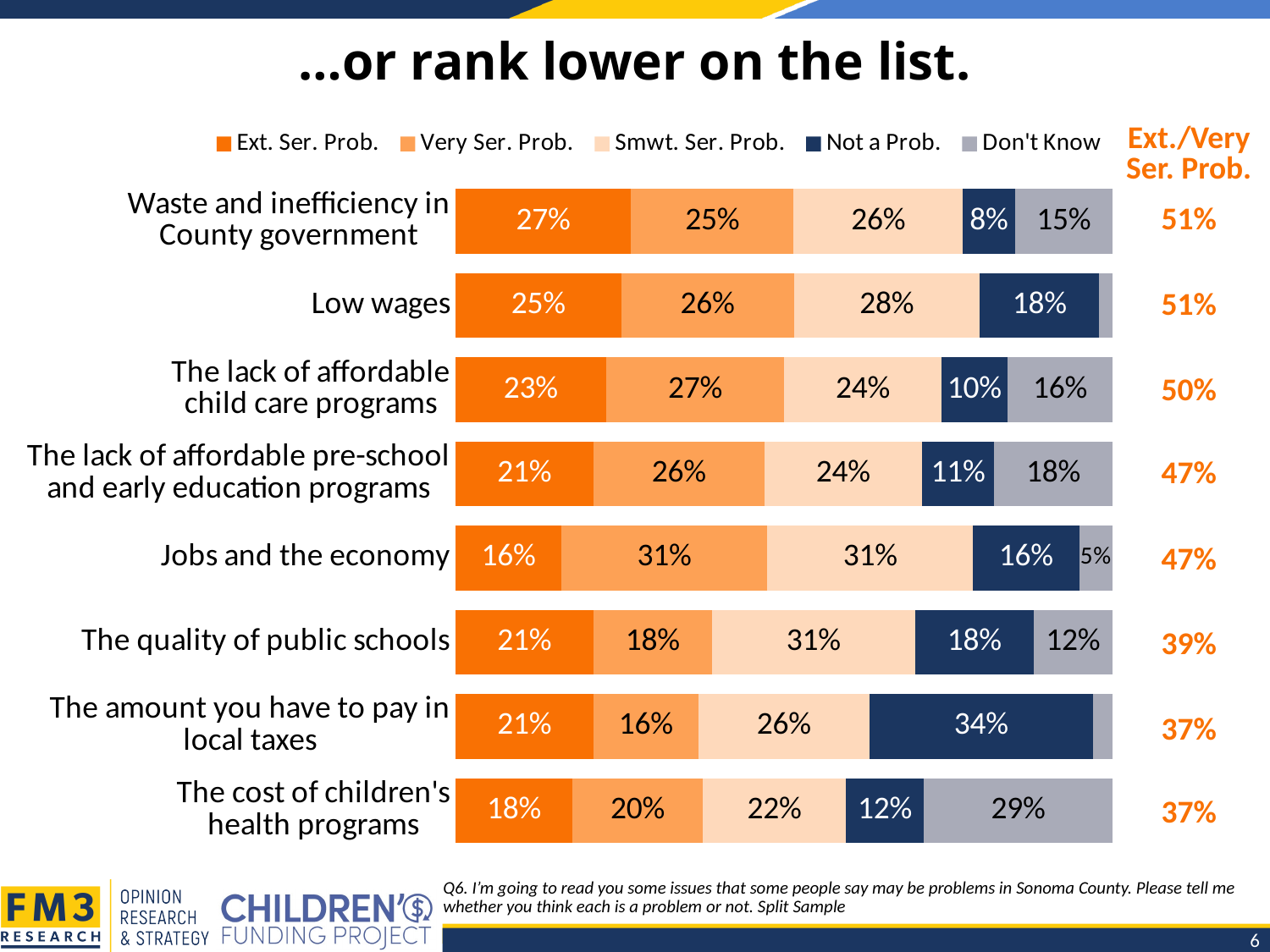
Which category has the highest Ext. Ser. Prob. value? Waste and inefficiency in County government What percentage of respondents said "Waste and inefficiency in County government" is an Ext. Ser. Prob.? 27% How many categories (issues) are shown in the chart? 8 What is the title of the slide? …or rank lower on the list. How many series does the legend list? 5 What is the Not a Prob. value for "The amount you have to pay in local taxes"? 34% Which category has the lowest Ext. Ser. Prob. value? Jobs and the economy Which has a larger Very Ser. Prob. value: "Jobs and the economy" or "The quality of public schools"? Jobs and the economy What is the Don't Know value for "The cost of children's health programs"? 29% What is the combined Ext./Very Ser. Prob. figure shown for "The quality of public schools"? 39% What kind of chart is shown on the slide? Stacked bar chart What is the difference between the Not a Prob. values for "The amount you have to pay in local taxes" and "Low wages"? 16%